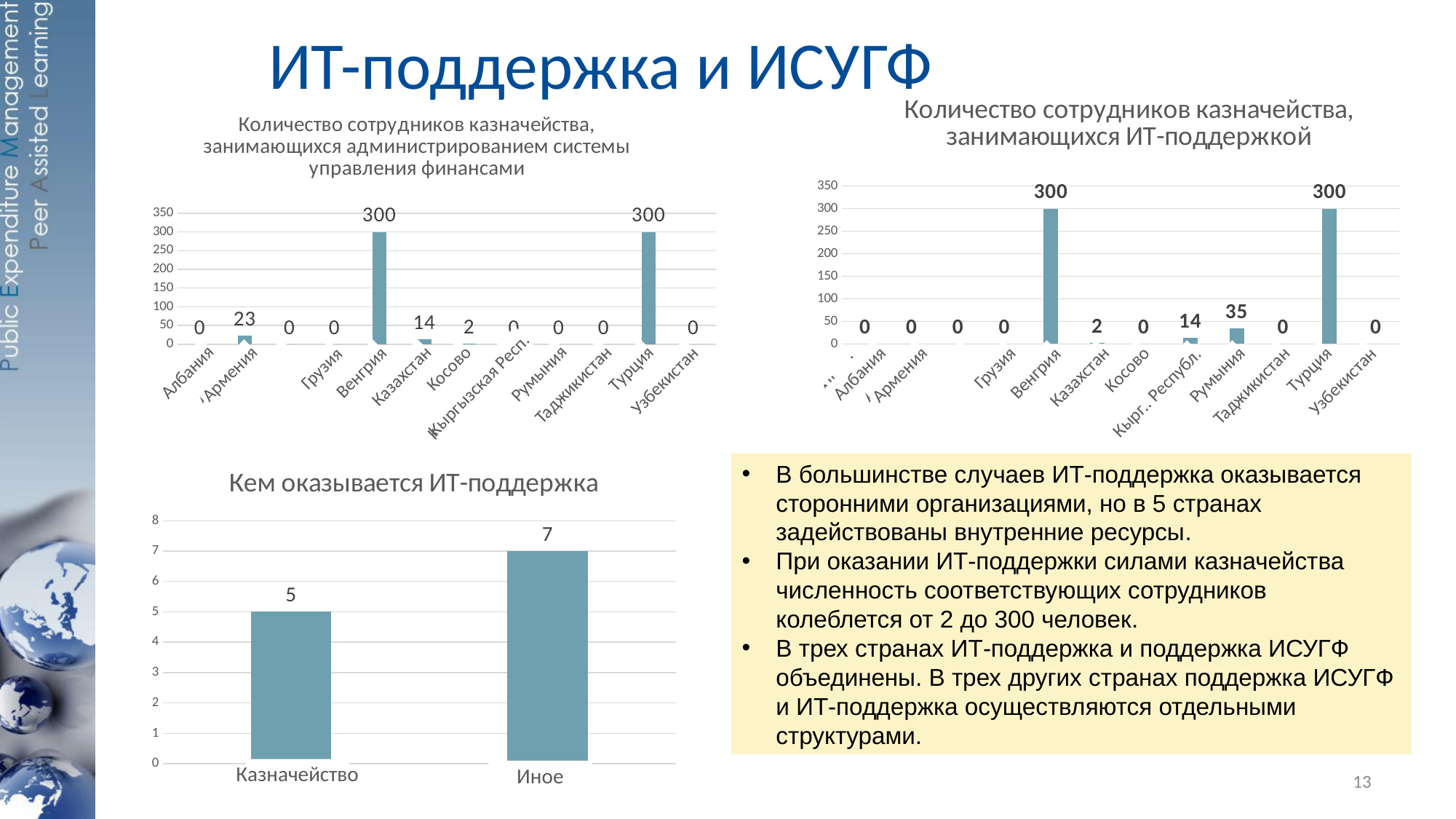
In the chart 'Количество сотрудников казначейства, занимающихся администрированием системы управления финансами', what is the difference between the values for Армения and Казахстан? 9 In the chart 'Кем оказывается ИТ-поддержка', what is the value for Казначейство? 5 In the chart 'Количество сотрудников казначейства, занимающихся ИТ-поддержкой', what is the difference between the values for Румыния and Кырг. Республ.? 21 In the chart 'Кем оказывается ИТ-поддержка', what is the difference between the values for Иное and Казначейство? 2 In the chart 'Количество сотрудников казначейства, занимающихся администрированием системы управления финансами', what is the value for Казахстан? 14 In the chart 'Количество сотрудников казначейства, занимающихся ИТ-поддержкой', what is the value for Румыния? 35 In the chart 'Количество сотрудников казначейства, занимающихся администрированием системы управления финансами', what is the value for Косово? 2 In the chart 'Количество сотрудников казначейства, занимающихся ИТ-поддержкой', what is the value for Казахстан? 2 What kind of chart is 'Кем оказывается ИТ-поддержка'? bar chart In the chart 'Количество сотрудников казначейства, занимающихся ИТ-поддержкой', which is larger: the value for Румыния or the value for Казахстан? Румыния In the chart 'Количество сотрудников казначейства, занимающихся администрированием системы управления финансами', what is the value for Армения? 23 In the chart 'Кем оказывается ИТ-поддержка', which category has the highest value? Иное